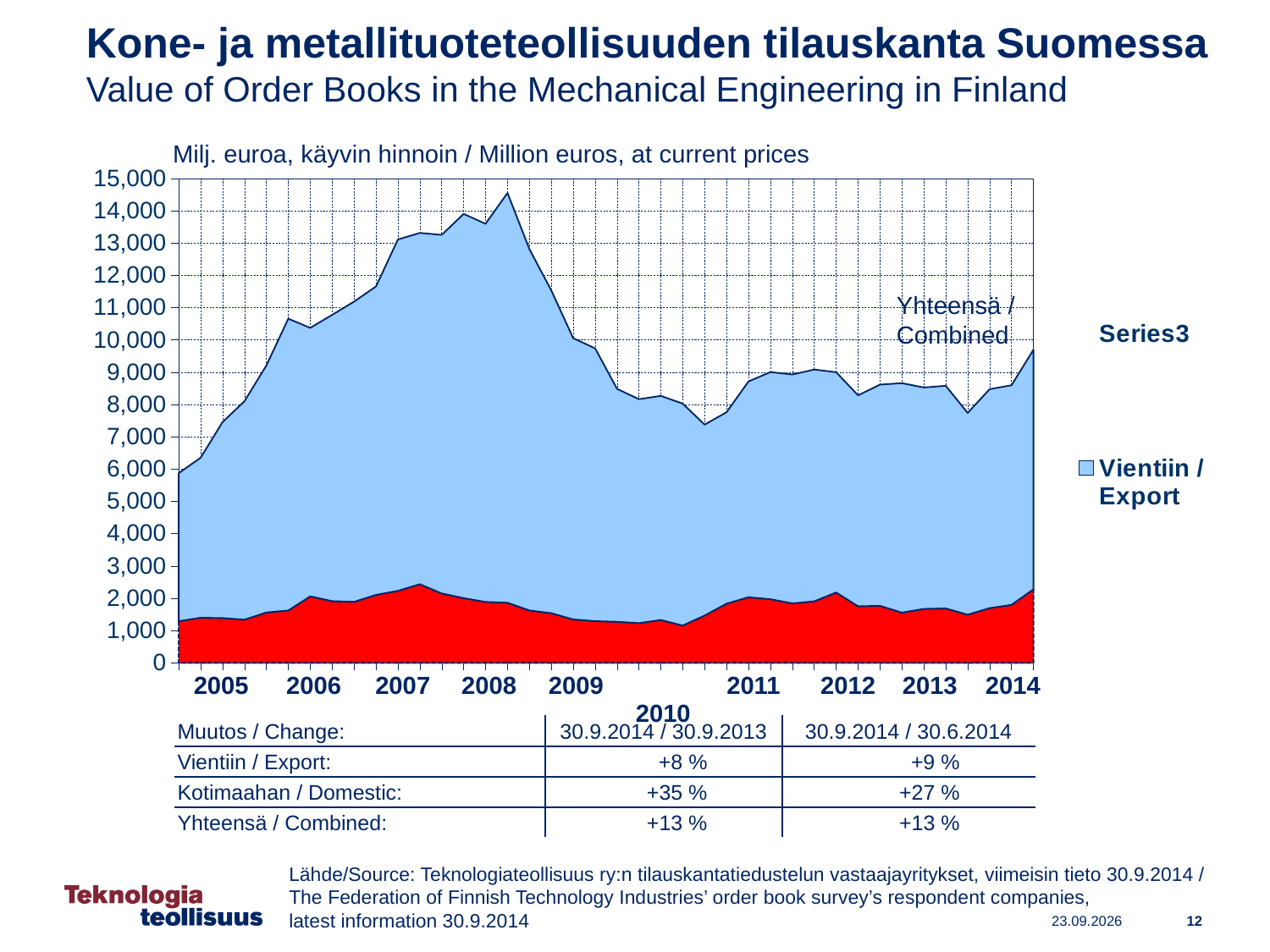
In which year is the combined (Yhteensä / Combined) order book at its lowest value? 2005 Is the value of the red area at the start of 2005 greater or less than 1,000? greater Is the combined (Yhteensä / Combined) order book value at the end of 2014 greater or less than 9,000? greater Does the combined (Yhteensä / Combined) order book rise or fall from 2008 to 2010? fall Is the highest value of the red area in 2007 greater or less than 3,000? less What kind of chart is shown on the slide? area chart In which year does the combined (Yhteensä / Combined) order book reach its highest value? 2008 How many year labels are shown along the x axis of the chart? 10 Which is larger, the combined (Yhteensä / Combined) order book in 2007 or in 2012? 2007 How many entries does the chart legend list? 2